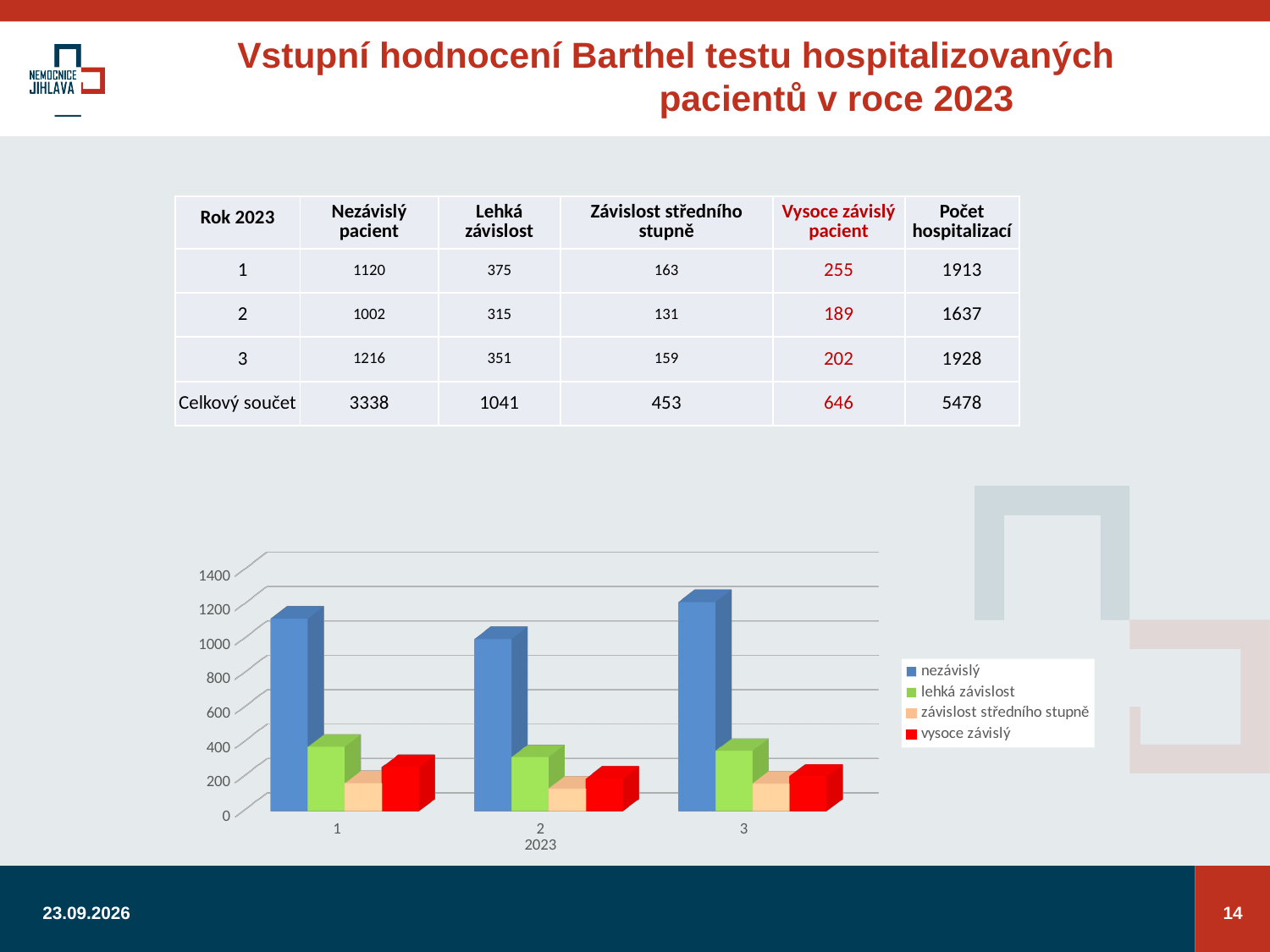
In category 1, which is larger: vysoce závislý or závislost středního stupně? vysoce závislý Using the values in the table, what is the difference between the nezávislý values for category 3 and category 1? 96 How many categories are shown along the x axis of the chart? 3 What year label appears beneath the category numbers on the x axis of the chart? 2023 Which category has the shortest nezávislý bar in the chart? 2 According to the table on the slide, what is the nezávislý pacient value plotted for category 1? 1120 Is the nezávislý value for category 2 greater or less than 800? greater What kind of chart is shown on the slide? bar chart How many series does the chart legend list? 4 Which category has the tallest nezávislý bar in the chart? 3 What colour represents the vysoce závislý series in the chart? red Is the lehká závislost value for category 1 greater or less than 600? less